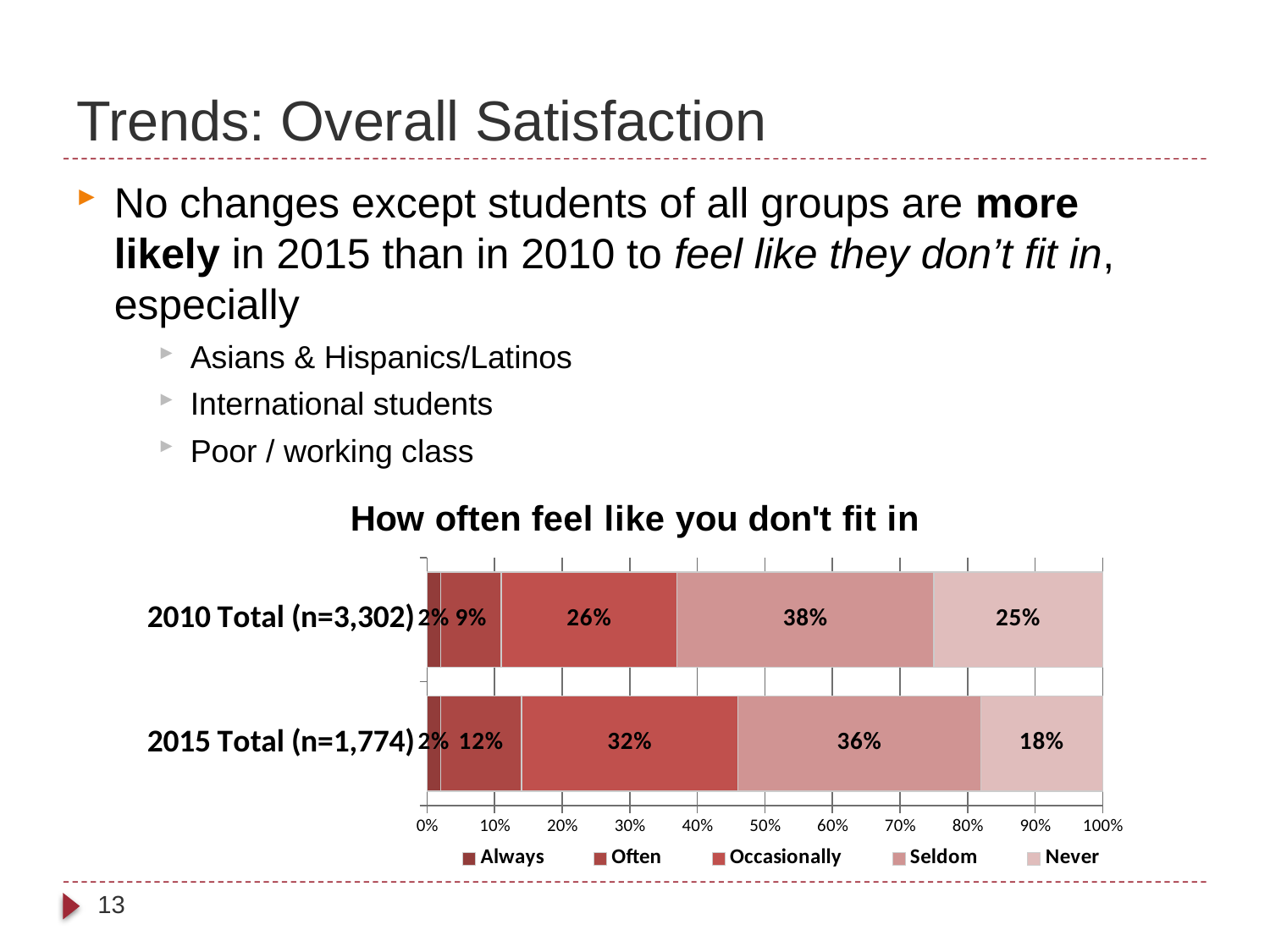
What is the Seldom value for 2015 Total (n=1,774)? 36% How many series does the chart legend list? 5 What type of chart is shown on the slide? Stacked bar chart Which segment is the largest in the 2010 Total (n=3,302) bar? Seldom What is the Never value for 2010 Total (n=3,302)? 25% How many bars (categories) are plotted in the chart? 2 Which segment is the smallest in the 2015 Total (n=1,774) bar? Always What is the Occasionally value for 2010 Total (n=3,302)? 26% What is the difference between the Occasionally values for 2015 Total (n=1,774) and 2010 Total (n=3,302)? 6% What is the Often value for 2015 Total (n=1,774)? 12% What is the title of the chart? How often feel like you don't fit in Which is larger: the Never value for 2010 Total (n=3,302) or the Never value for 2015 Total (n=1,774)? 2010 Total (n=3,302)